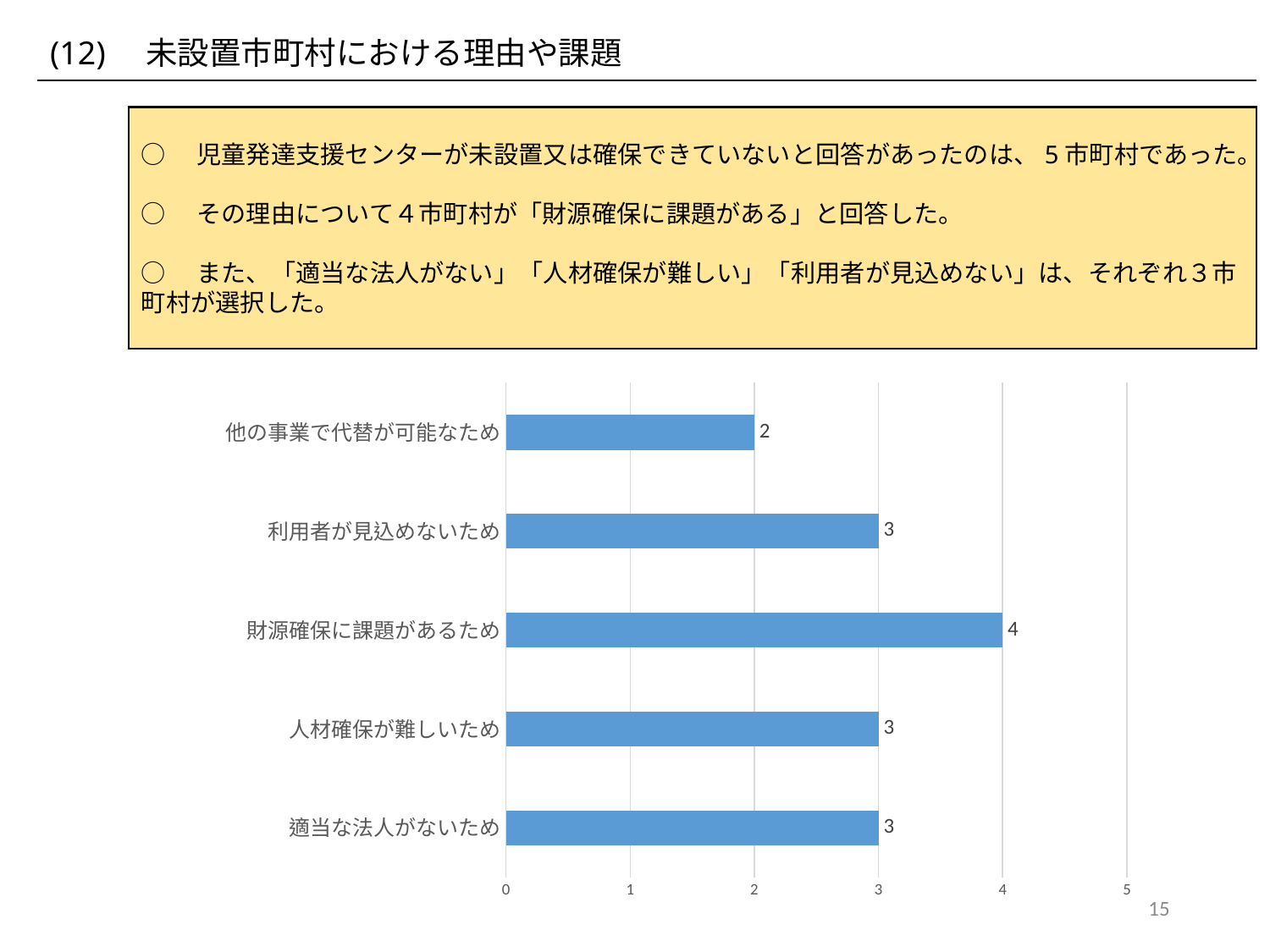
Which category has the lowest value? 他の事業で代替が可能なため What is the value for 適当な法人がないため? 3 Which is larger, the value for 人材確保が難しいため or the value for 他の事業で代替が可能なため? 人材確保が難しいため Which category has the highest value? 財源確保に課題があるため What is the value for 他の事業で代替が可能なため? 2 What is the difference between the values for 財源確保に課題があるため and 他の事業で代替が可能なため? 2 What is the value for 利用者が見込めないため? 3 How many categories are shown in the chart? 5 What is the maximum value shown on the horizontal axis? 5 What is the value for 財源確保に課題があるため? 4 Is the value for 財源確保に課題があるため greater or less than 3? greater What kind of chart is shown on the slide? bar chart